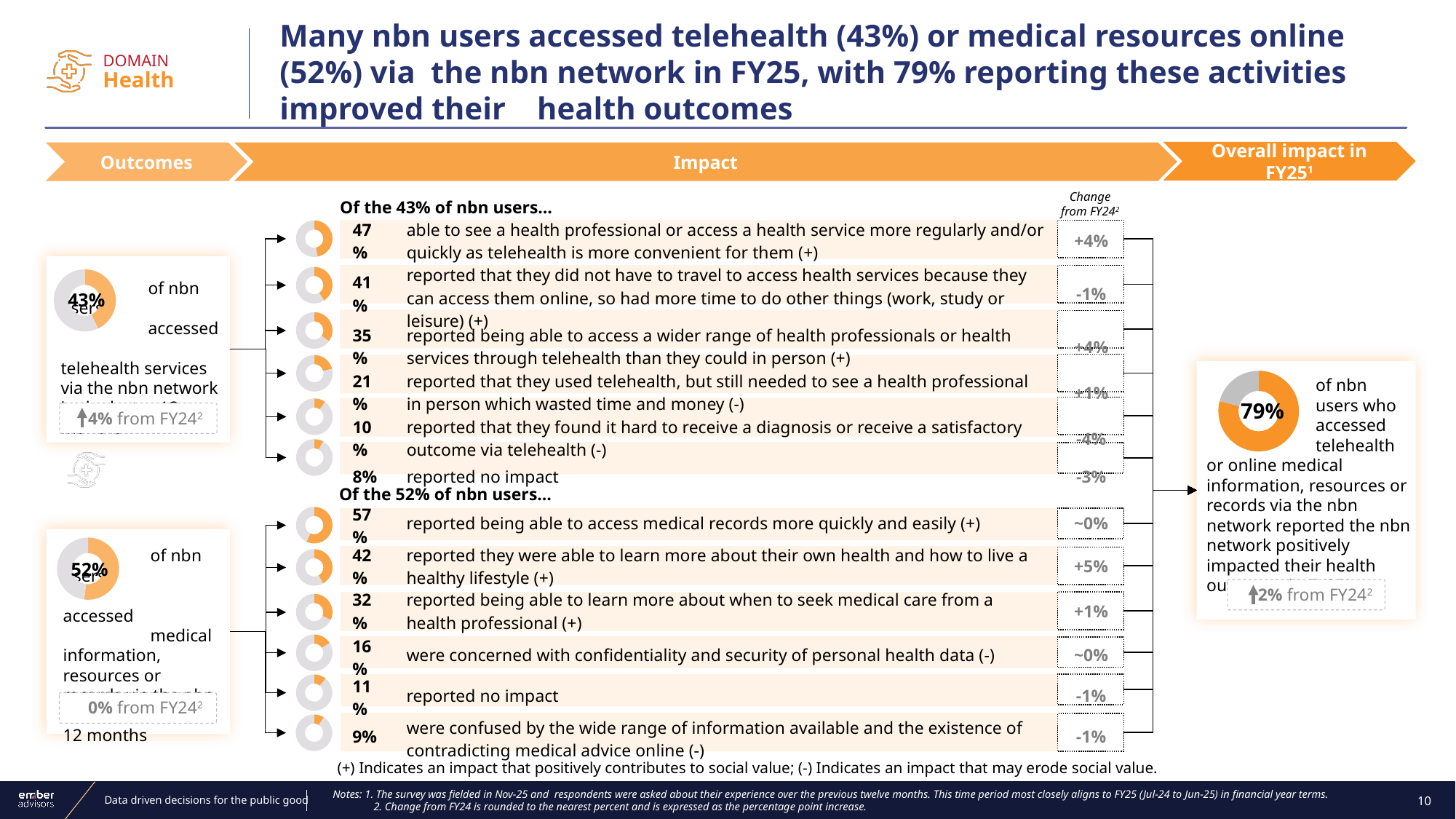
What percentage is shown in the donut chart for nbn users who accessed telehealth services via the nbn network? 43% Which is larger: the percentage of telehealth users who reported not having to travel to access health services (41%) or the percentage who reported accessing a wider range of health professionals (35%)? 41% (did not have to travel) Among the 52% of nbn users who accessed medical information online, what percentage were concerned with confidentiality and security of personal health data? 16% In the 'Overall impact in FY25' donut chart on the right, what percentage of nbn users reported the nbn network positively impacted their health outcomes? 79% What percentage is shown in the donut chart for nbn users who accessed medical information, resources or records via the nbn network? 52% Among the 52% of nbn users who accessed medical information online, what percentage reported being able to access medical records more quickly and easily? 57% What kind of chart is used to show the 79% overall impact figure? Donut chart Among the 43% of nbn users who accessed telehealth, what percentage reported no impact? 8% What is the difference between the share of nbn users who accessed medical resources online (52%) and the share who accessed telehealth (43%)? 9 percentage points Among the 43% of nbn users who accessed telehealth, what percentage were able to see a health professional or access a health service more regularly and/or quickly? 47% Which impact has the lowest percentage among the 43% of nbn users who accessed telehealth? Reported no impact (8%) Which impact has the highest percentage among the 52% of nbn users who accessed medical information online? Reported being able to access medical records more quickly and easily (57%)